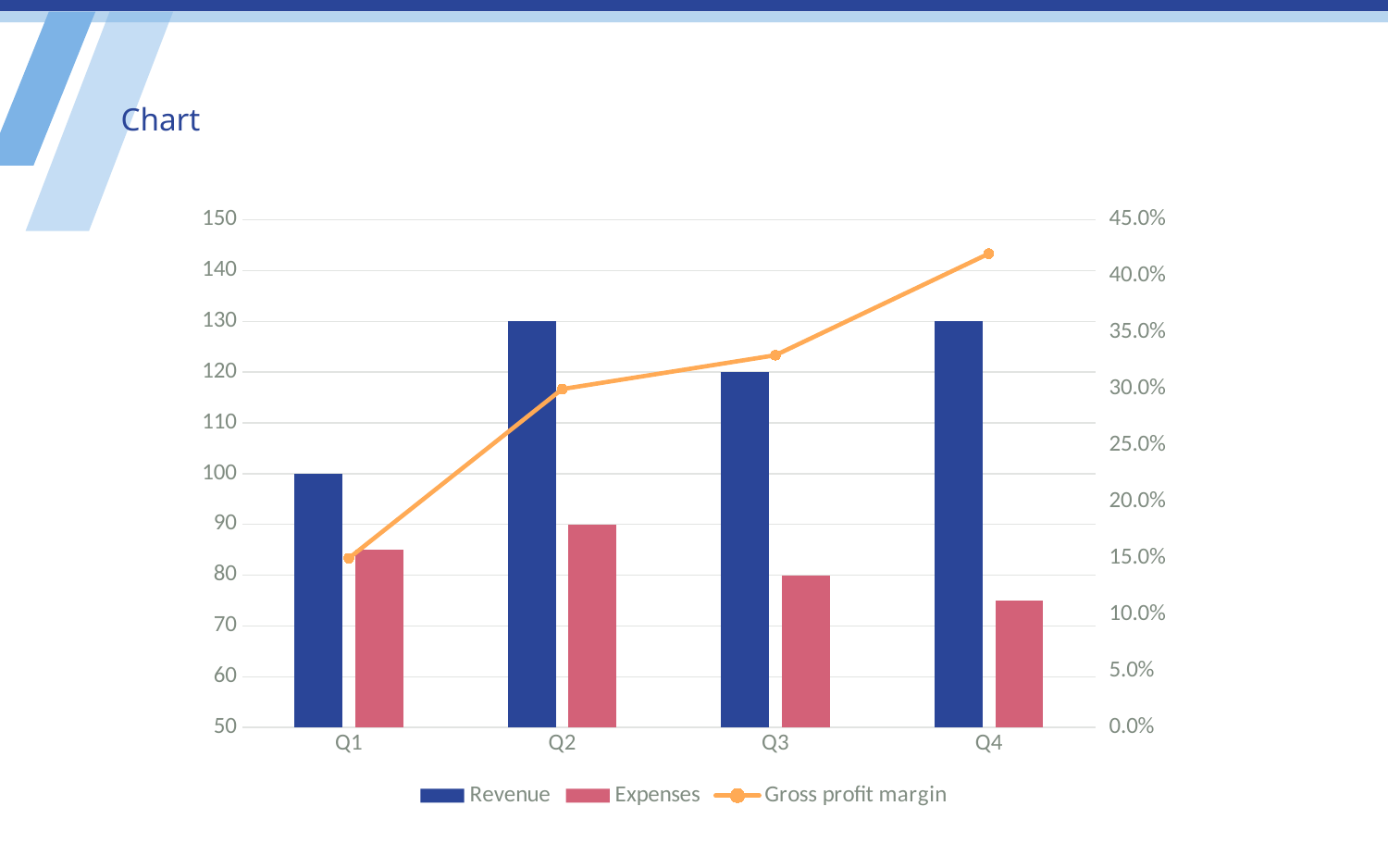
What is the Revenue value for Q1? 100 How many quarters are shown on the x axis? 4 Which quarter has the lowest Revenue? Q1 What is the difference between Revenue in Q2 and Revenue in Q1? 30 Is the Gross profit margin for Q4 greater or less than 40.0%? greater How many series does the legend list? 3 What is the Expenses value for Q2? 90 What kind of chart is shown on the slide? A combination bar and line chart What is the Revenue value for Q2? 130 Does the Gross profit margin rise or fall from Q1 to Q4? Rises Which quarter has the highest Expenses? Q2 What is the Expenses value for Q3? 80